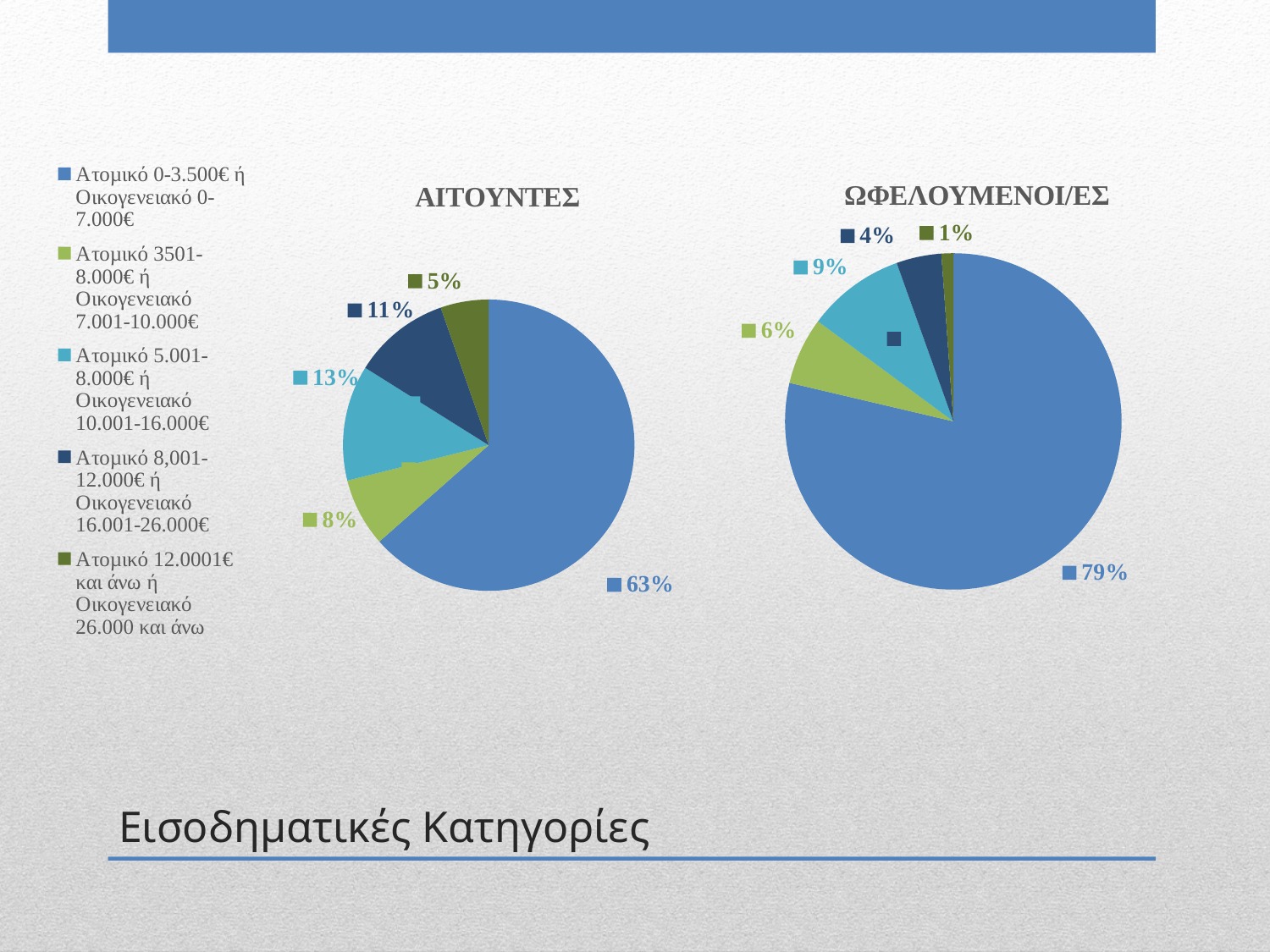
In the ΩΦΕΛΟΥΜΕΝΟΙ/ΕΣ chart, which category has the smallest share? Ατομικό 12.0001€ και άνω ή Οικογενειακό 26.000 και άνω In the ΑΙΤΟΥΝΤΕΣ chart, what is the share for the category Ατομικό 12.0001€ και άνω ή Οικογενειακό 26.000 και άνω? 5% In the ΑΙΤΟΥΝΤΕΣ chart, which is larger: the share for Ατομικό 3501-8.000€ ή Οικογενειακό 7.001-10.000€ or the share for Ατομικό 8,001-12.000€ ή Οικογενειακό 16.001-26.000€? Ατομικό 8,001-12.000€ ή Οικογενειακό 16.001-26.000€ What is the difference between the share of the largest slice in the ΩΦΕΛΟΥΜΕΝΟΙ/ΕΣ chart and the share of the largest slice in the ΑΙΤΟΥΝΤΕΣ chart? 16% How many slices does the ΩΦΕΛΟΥΜΕΝΟΙ/ΕΣ pie chart have? 5 In the ΑΙΤΟΥΝΤΕΣ chart, what is the share for the category Ατομικό 5.001-8.000€ ή Οικογενειακό 10.001-16.000€? 13% In the ΩΦΕΛΟΥΜΕΝΟΙ/ΕΣ chart, what is the share for the category Ατομικό 0-3.500€ ή Οικογενειακό 0-7.000€? 79% In the ΑΙΤΟΥΝΤΕΣ chart, which category has the largest share? Ατομικό 0-3.500€ ή Οικογενειακό 0-7.000€ How many categories does the legend list? 5 What kind of chart is the ΑΙΤΟΥΝΤΕΣ chart? pie chart In the ΩΦΕΛΟΥΜΕΝΟΙ/ΕΣ chart, what is the share for the category Ατομικό 8,001-12.000€ ή Οικογενειακό 16.001-26.000€? 4% In the ΑΙΤΟΥΝΤΕΣ chart, what is the share for the category Ατομικό 0-3.500€ ή Οικογενειακό 0-7.000€? 63%